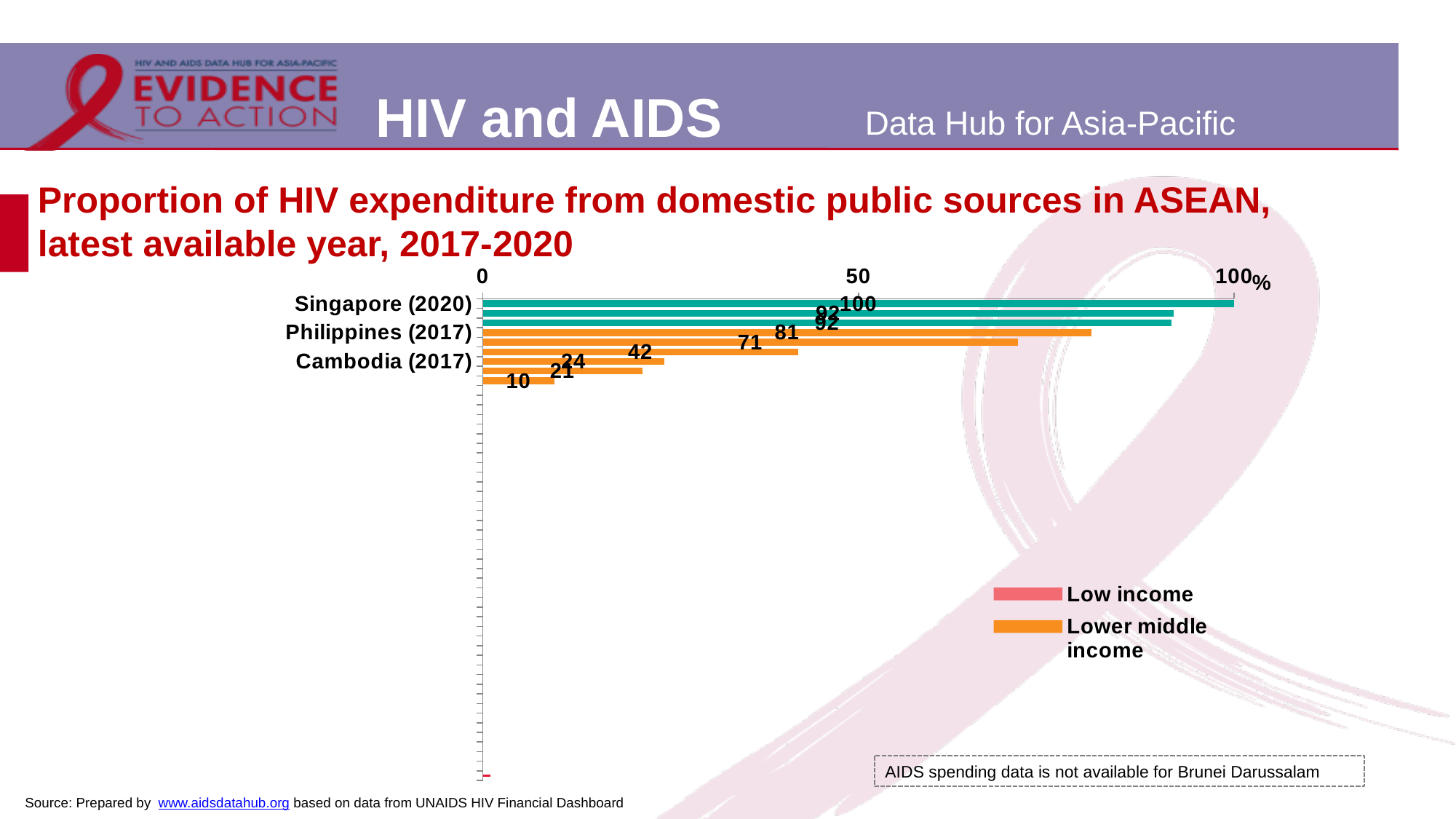
What are the two entries in the chart legend? Low income; Lower middle income What is the highest value labelled on the chart? 100 What is the title of the chart? Proportion of HIV expenditure from domestic public sources in ASEAN, latest available year, 2017-2020 What is the difference between the highest and lowest labelled values on the chart? 90 What is the value shown for Singapore (2020)? 100 What kind of chart is shown on the slide? bar chart What is the lowest value labelled on the chart? 10 Which has a higher proportion of HIV expenditure from domestic public sources, Singapore (2020) or Cambodia (2017)? Singapore (2020) How many entries does the legend list? 2 What is the maximum value shown on the chart's axis? 100% Is the value for Singapore (2020) greater or less than 50? greater